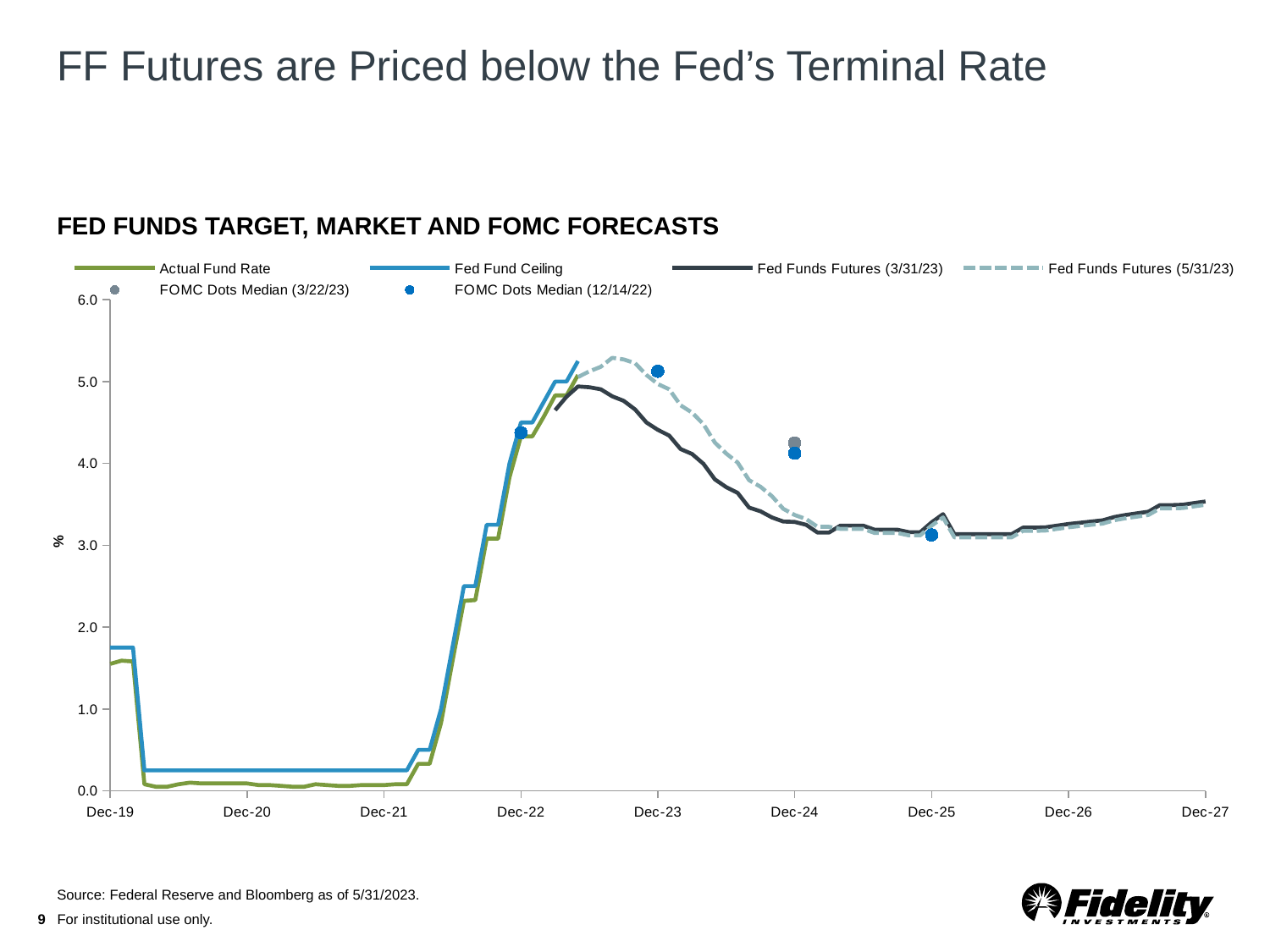
Is the Fed Fund Ceiling at Dec-20 greater or less than 1.0? less What kind of chart is shown on the slide? Line chart Is the FOMC Dots Median (12/14/22) value at Dec-25 greater or less than 4.0? less Does the Fed Funds Futures (3/31/23) line rise or fall between Dec-23 and Dec-24? Fall Is the FOMC Dots Median (3/22/23) value at Dec-24 greater or less than 4.0? greater What is the label on the vertical axis of the chart? % How many series does the chart legend list? 6 How many date labels are shown along the x axis? 9 At Dec-23, which is higher: Fed Funds Futures (5/31/23) or Fed Funds Futures (3/31/23)? Fed Funds Futures (5/31/23) What is the title of the chart? FED FUNDS TARGET, MARKET AND FOMC FORECASTS Does the Actual Fund Rate rise or fall between Dec-21 and Dec-22? Rise